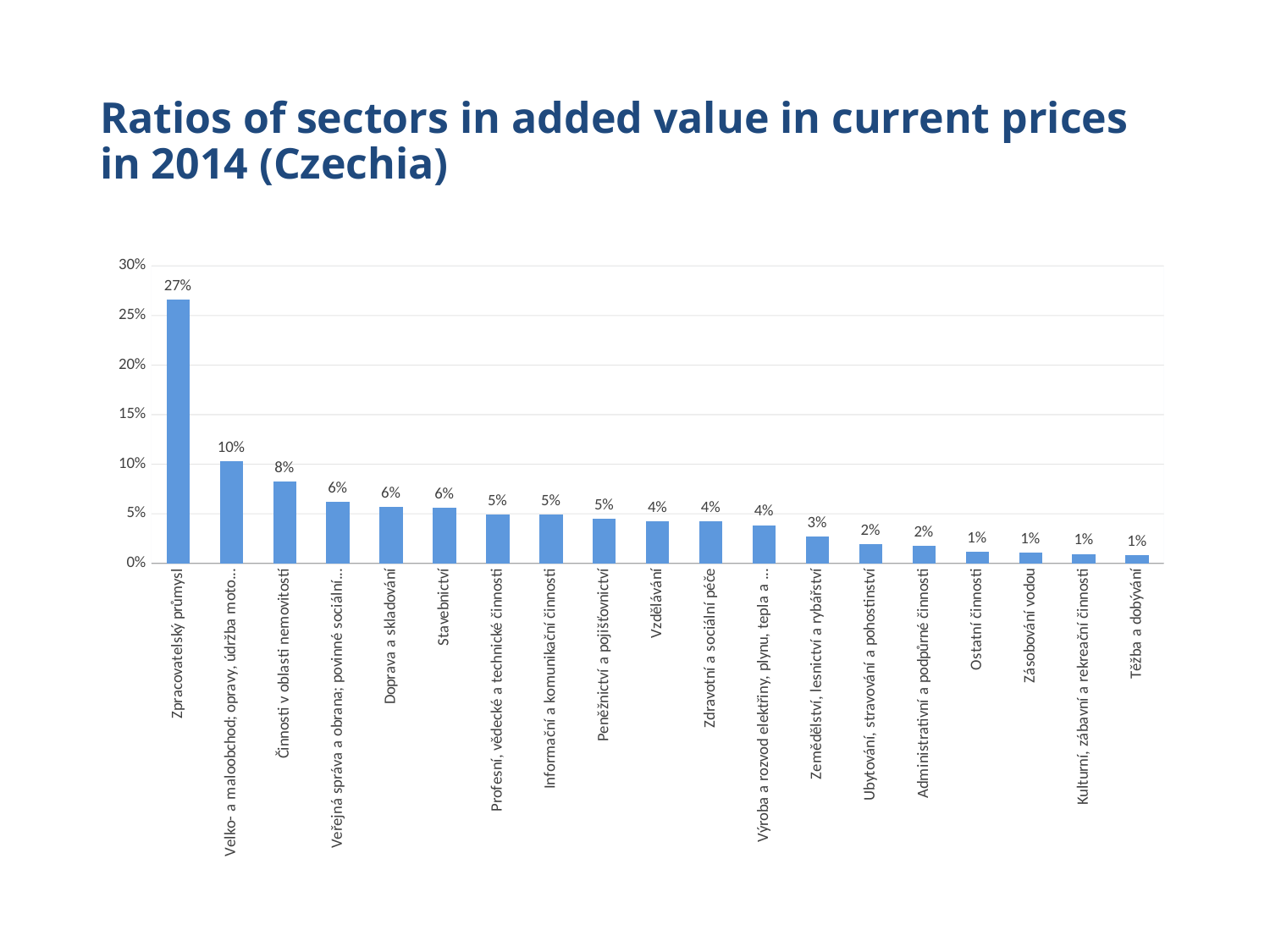
What is the value for Činnosti v oblasti nemovitostí? 8% What is the value for Stavebnictví? 6% How many sectors are shown in the chart? 19 What is the difference between the values for Zpracovatelský průmysl and Činnosti v oblasti nemovitostí? 19 percentage points Which is larger, the value for Doprava a skladování or the value for Zdravotní a sociální péče? Doprava a skladování Is the value for Zpracovatelský průmysl greater or less than 25%? greater What is the value for Zemědělství, lesnictví a rybářství? 3% What is the value for Vzdělávání? 4% What is the title of the slide? Ratios of sectors in added value in current prices in 2014 (Czechia) What is the value for Zpracovatelský průmysl? 27% Which sector has the highest ratio? Zpracovatelský průmysl What kind of chart is shown on the slide? bar chart